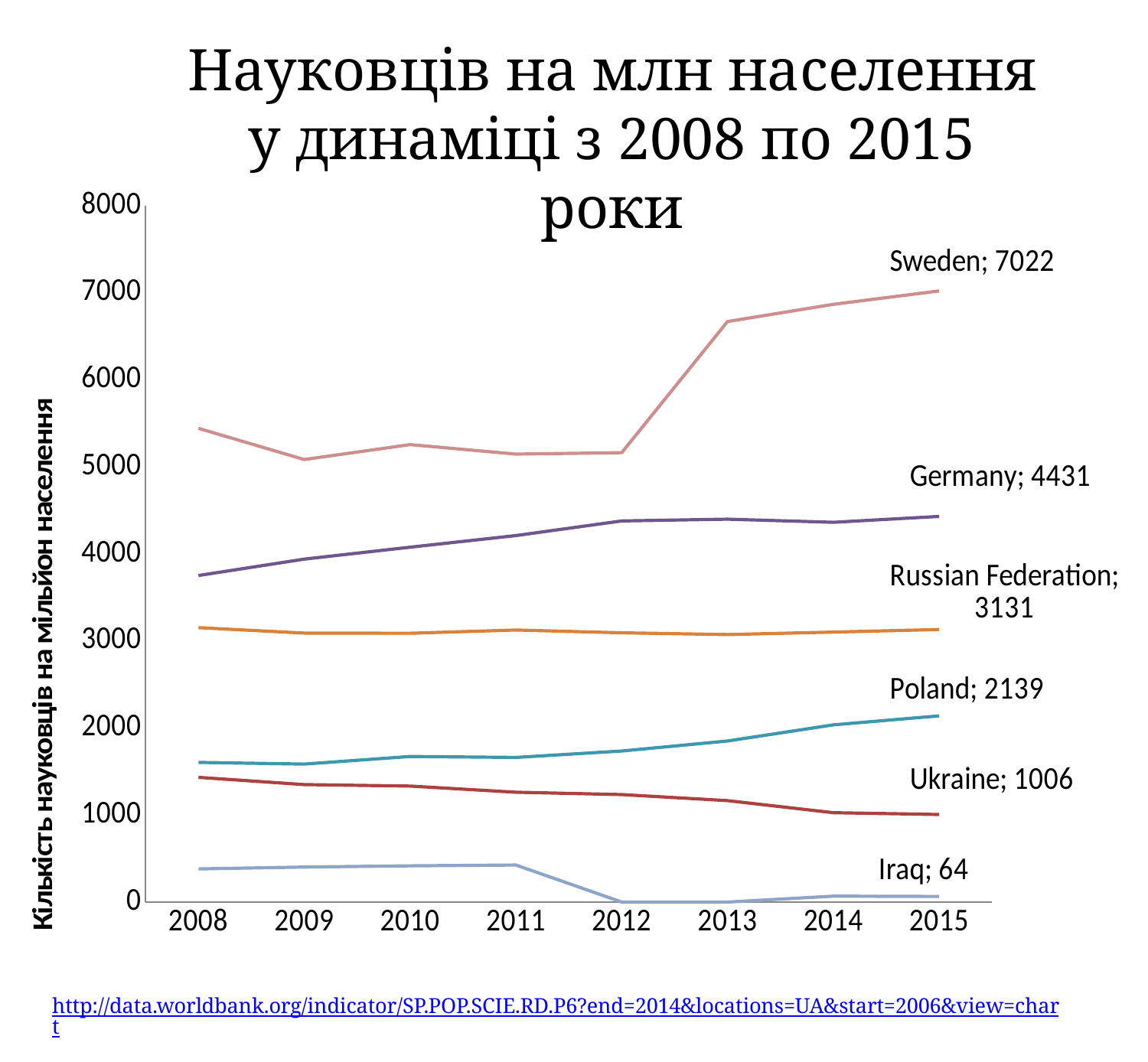
What is the value for Poland in 2015? 2139 Does the value for Ukraine rise or fall from 2008 to 2015? fall Is the value for Sweden in 2008 greater or less than 5000? greater Which country has the highest value in 2015? Sweden How many years are shown on the x axis? 8 Is the value for Germany in 2008 greater or less than 4000? less How many countries are plotted on the chart? 6 What is the difference between Germany's and Russian Federation's values in 2015? 1300 Which country has the lowest value in 2015? Iraq In 2015, which is larger: the value for Poland or the value for Ukraine? Poland What is the value for Ukraine in 2015? 1006 What is the value for Sweden in 2015? 7022